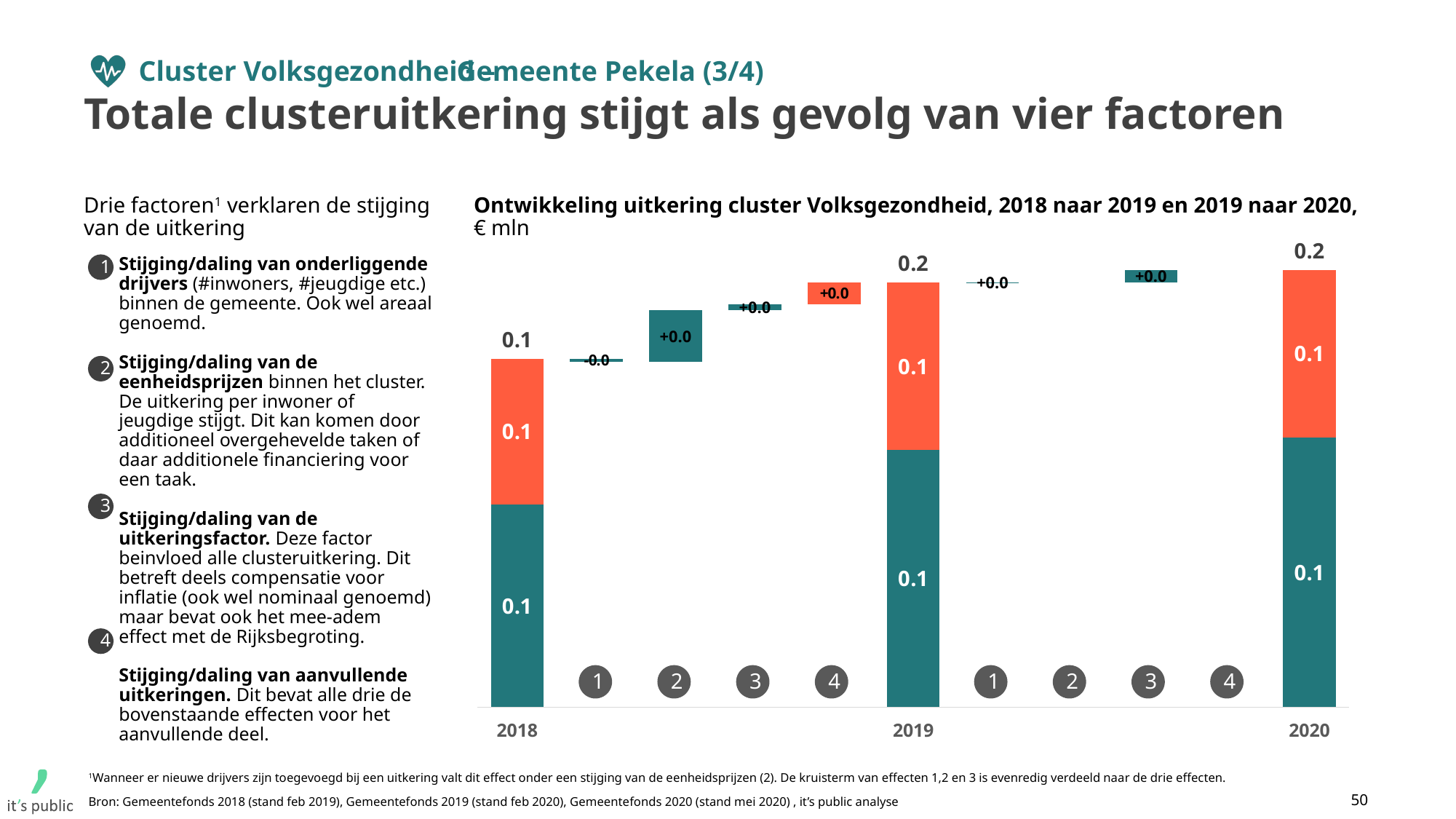
What is the total value shown above the 2020 bar? 0.2 What unit is stated in the chart title? € mln What is the total value shown above the 2019 bar? 0.2 How many years are shown on the x axis of the chart? 3 What value is labelled on factor bar 2 between 2018 and 2019? +0.0 What kind of chart is shown on the slide? Bar chart (waterfall) What value is labelled on the orange (top) segment of the 2020 bar? 0.1 What value is labelled on factor bar 1 between 2018 and 2019? -0.0 What value is labelled on the teal (bottom) segment of the 2019 bar? 0.1 Which year has the lowest total value in the chart? 2018 Which year has the larger total, 2018 or 2019? 2019 What is the total value shown above the 2018 bar? 0.1